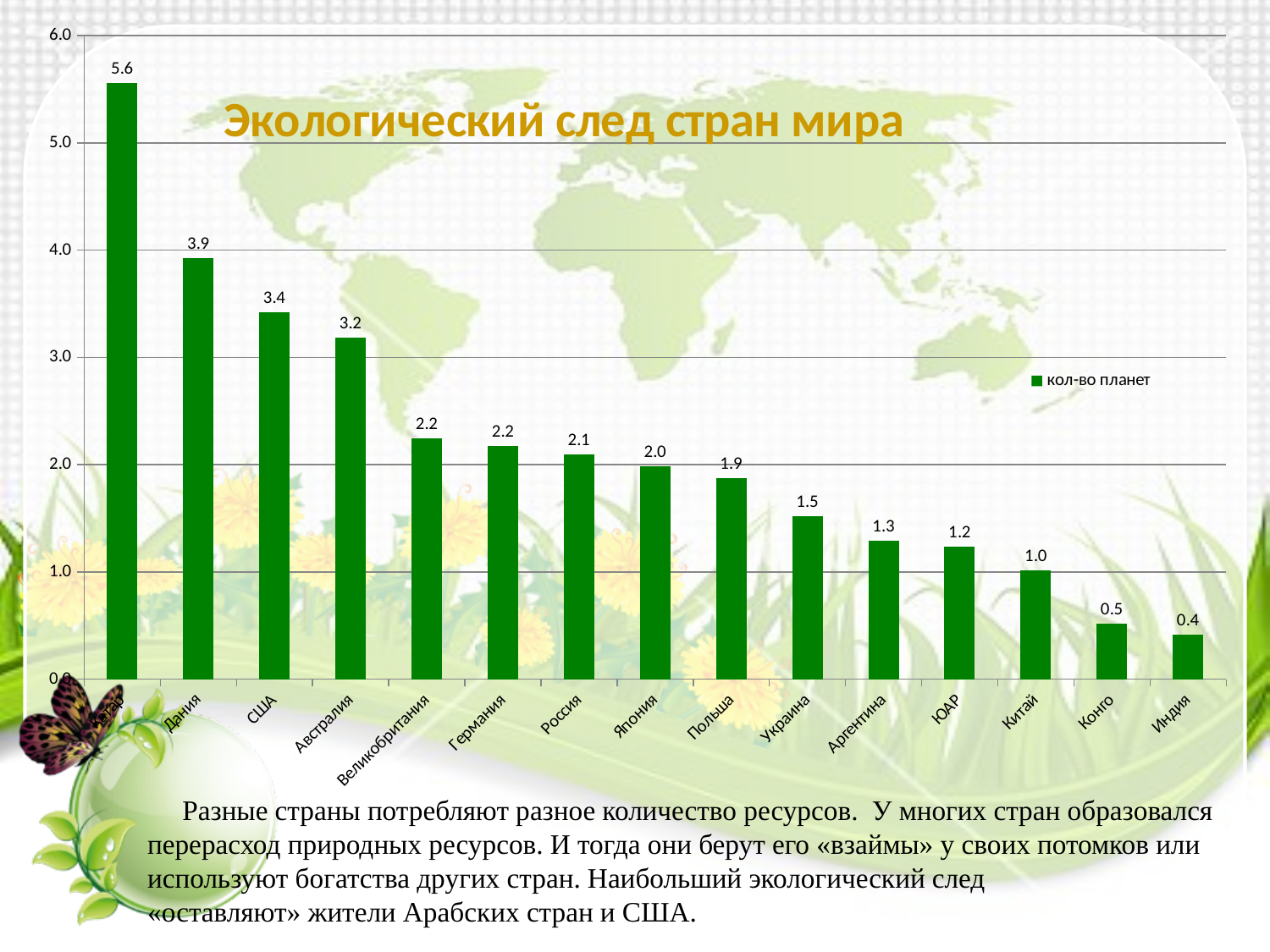
What is the value for Дания? 3.9 What is the value for Россия? 2.1 Which country has the lowest value? Индия What kind of chart is shown? bar chart What is the value for Китай? 1.0 Which has a larger value, Австралия or Япония? Австралия How many series does the legend list? 1 What is the highest value shown on the chart? 5.6 How many countries are shown on the chart? 15 What is the difference between the values for Дания and Индия? 3.5 What is the value for США? 3.4 What is the title of the chart? Экологический след стран мира